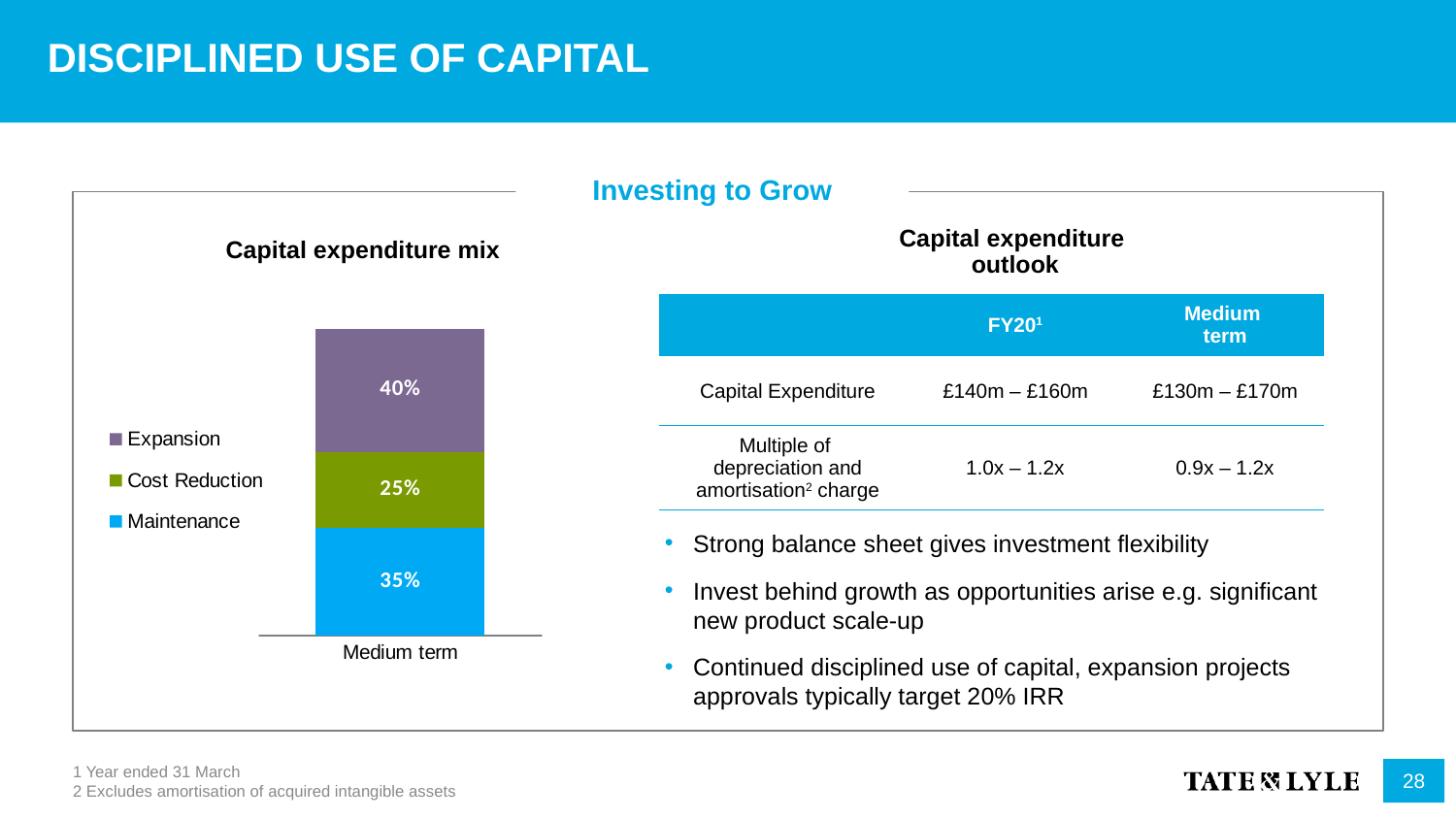
Which series has the largest share in the Capital expenditure mix chart? Expansion What is the total of the stacked bar in the Capital expenditure mix chart? 100% What is the difference between the Expansion and Maintenance values in the Capital expenditure mix chart? 5% What is the value for Cost Reduction in the Capital expenditure mix chart? 25% How many series does the legend of the Capital expenditure mix chart list? 3 What is the value for Expansion in the Capital expenditure mix chart? 40% What is the difference between the Maintenance and Cost Reduction values in the Capital expenditure mix chart? 10% What is the value for Maintenance in the Capital expenditure mix chart? 35% Which is larger in the Capital expenditure mix chart, Expansion or Cost Reduction? Expansion Which series has the smallest share in the Capital expenditure mix chart? Cost Reduction What is the category label on the x axis of the Capital expenditure mix chart? Medium term What type of chart is the Capital expenditure mix chart? Stacked bar chart